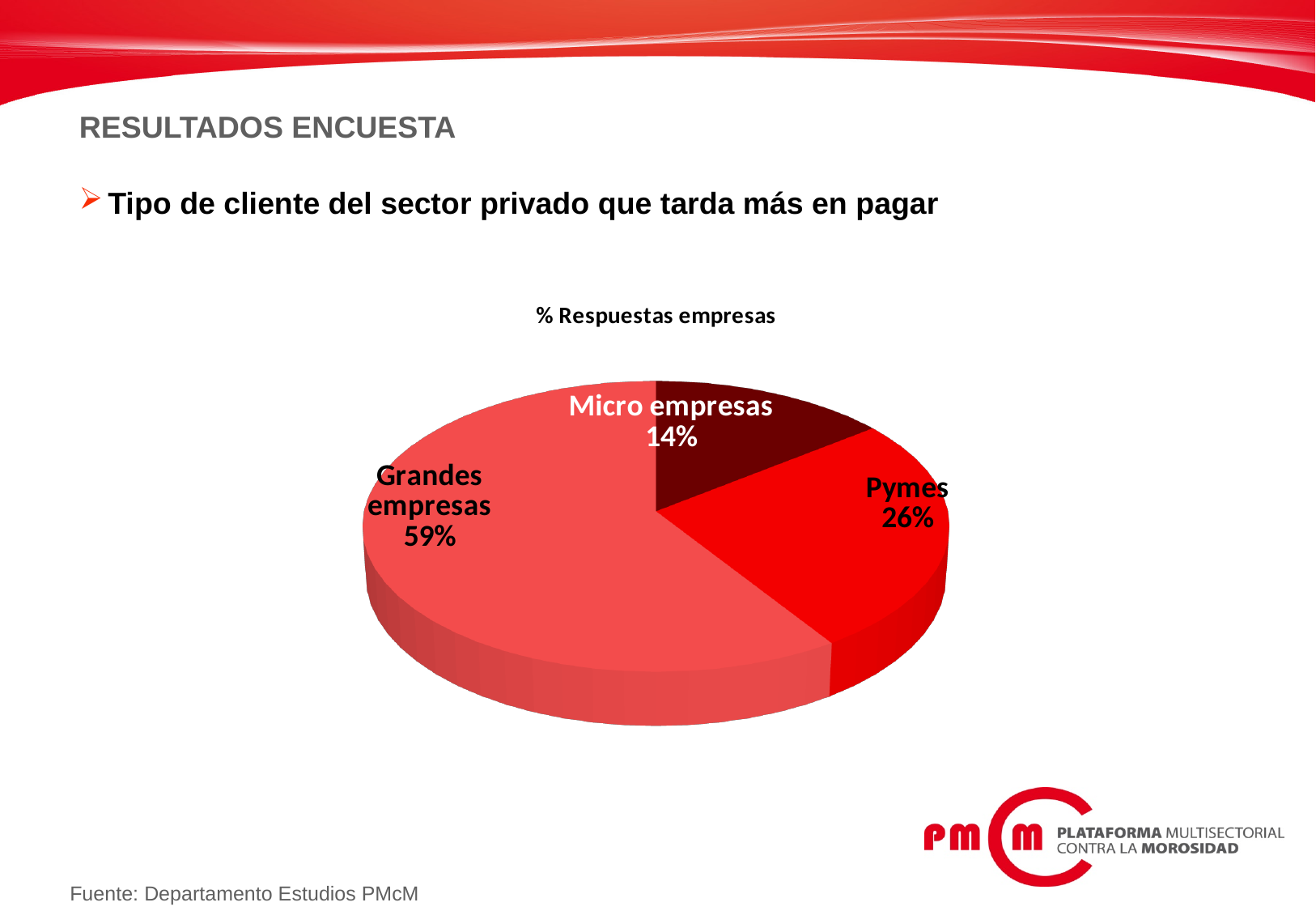
What percentage of responses corresponds to Micro empresas? 14% What is the difference in percentage points between Pymes and Micro empresas? 12 Which is larger, the share for Pymes or the share for Micro empresas? Pymes Which category has the smallest share of the pie? Micro empresas What percentage of responses corresponds to Grandes empresas? 59% What is the title of the chart? % Respuestas empresas What is the difference in percentage points between Grandes empresas and Pymes? 33 What percentage of responses corresponds to Pymes? 26% Which slice of the pie is the darkest red? Micro empresas How many categories are shown in the pie chart? 3 What type of chart is shown on the slide? Pie chart Which category has the largest share of the pie? Grandes empresas